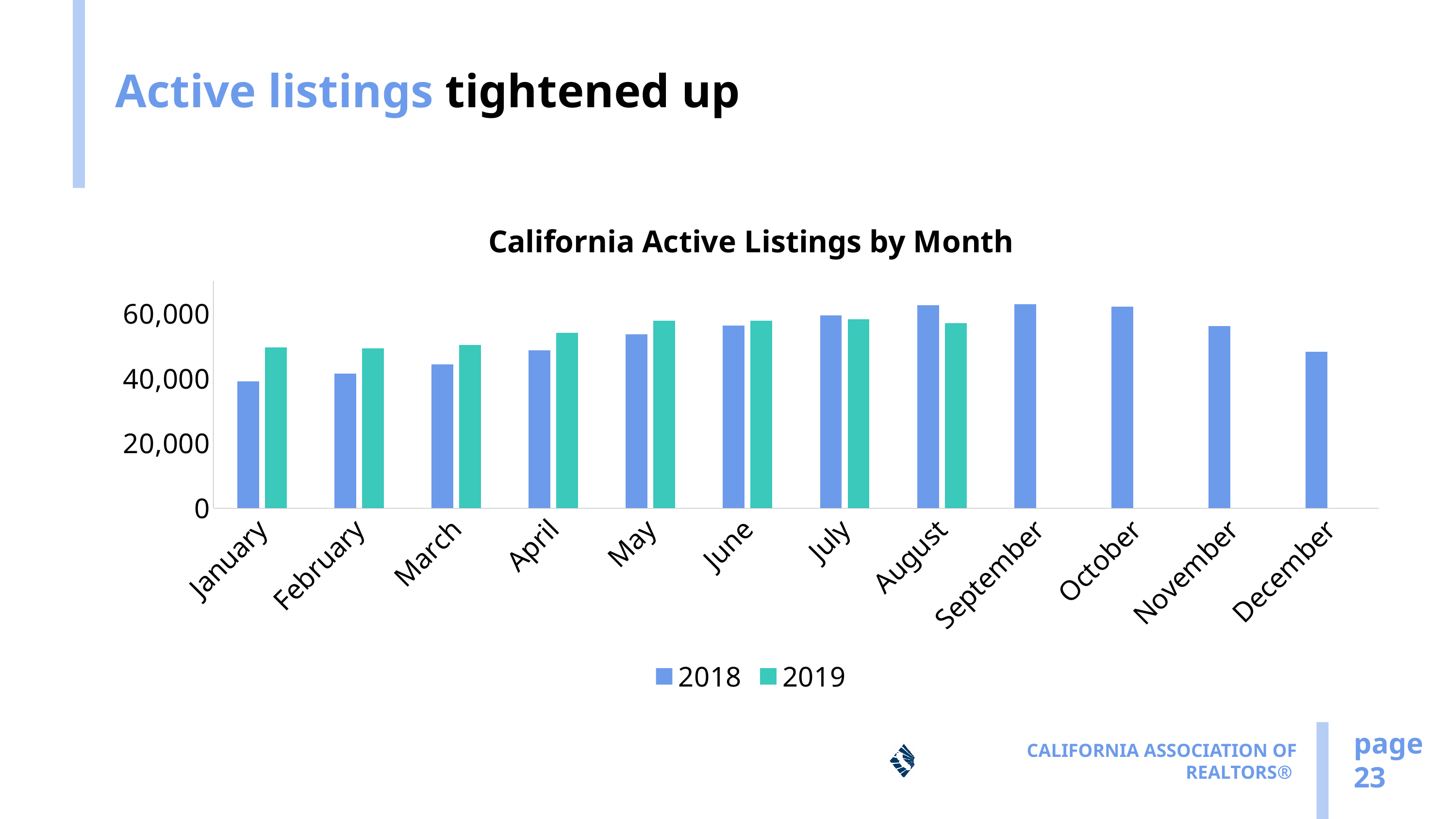
In August, which series has the larger value, 2018 or 2019? 2018 In January, which series has the larger value, 2018 or 2019? 2019 What kind of chart is shown on the slide? bar chart Is the value for May 2019 greater or less than 60,000? less Which month has the lowest value for 2018? January Is the value for September 2018 greater or less than 60,000? greater How many series does the legend list? 2 Is the value for December 2018 greater or less than 60,000? less Do the 2018 values rise or fall from January to September? rise How many months are shown on the x axis? 12